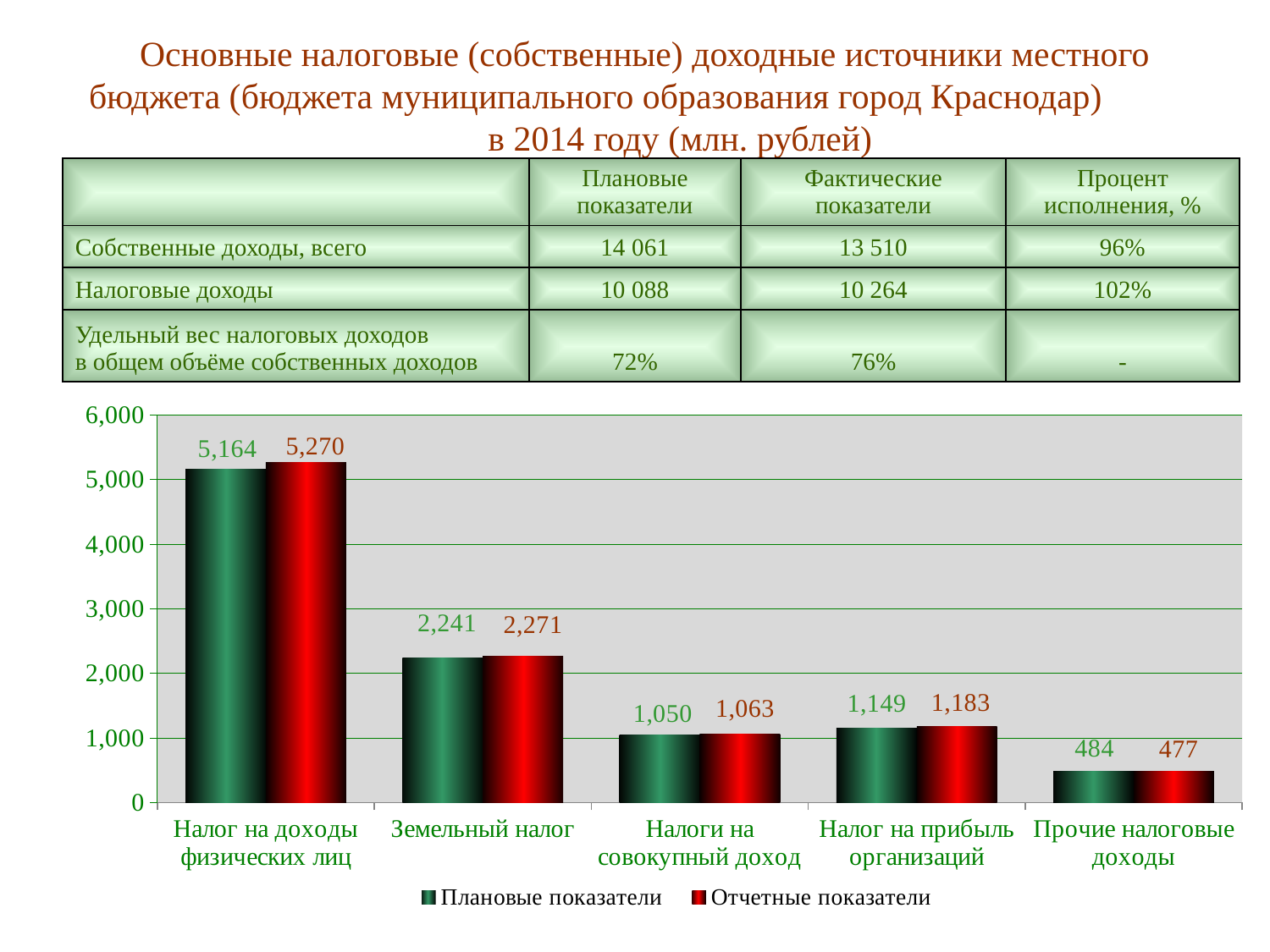
What colour are the bars for Отчетные показатели in the chart? Red What is the reported value (Отчетные показатели) for Прочие налоговые доходы? 477 Which category has the highest planned value (Плановые показатели)? Налог на доходы физических лиц How many categories are shown on the x axis of the chart? 5 Which category has the lowest reported value (Отчетные показатели)? Прочие налоговые доходы What is the reported value (Отчетные показатели) for Земельный налог? 2,271 What is the planned value (Плановые показатели) for Налог на доходы физических лиц? 5,164 How many series does the chart legend list? 2 What is the difference between the planned and reported values for Прочие налоговые доходы? 7 Which is larger: the planned value for Налог на прибыль организаций or the planned value for Налоги на совокупный доход? Налог на прибыль организаций What kind of chart is shown on the slide? Bar chart What is the difference between the reported and planned values for Налог на доходы физических лиц? 106